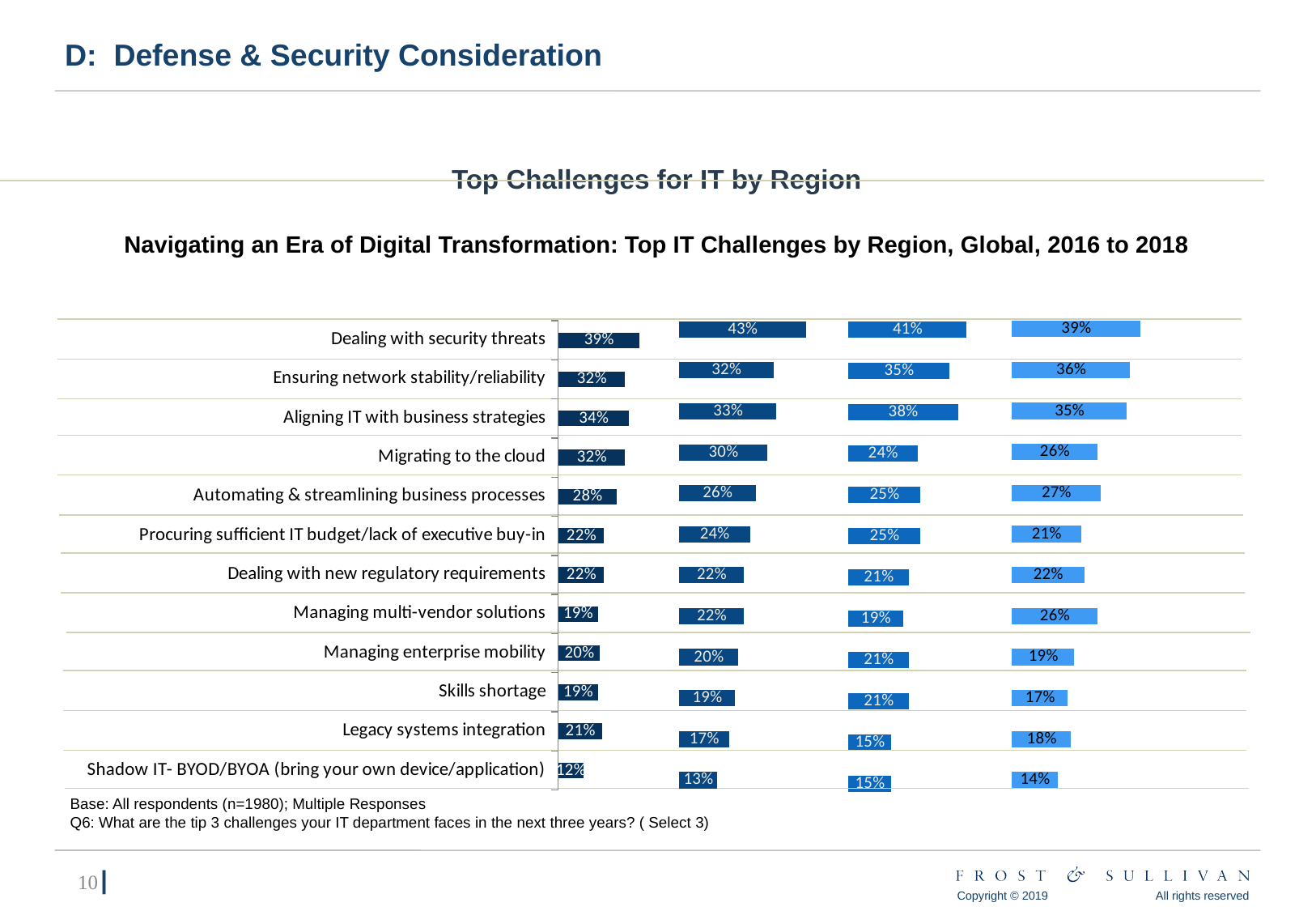
What is the title of the chart on the slide? Navigating an Era of Digital Transformation: Top IT Challenges by Region, Global, 2016 to 2018 In the leftmost column of bars, what is the difference between 'Legacy systems integration' (21%) and 'Shadow IT- BYOD/BYOA' (12%)? 9% How many IT challenge categories are listed in the chart? 12 Which challenge has the highest value in the second column of bars from the left? Dealing with security threats In the leftmost (first) column of bars, what is the value for 'Dealing with security threats'? 39% In the rightmost column of bars, what is the difference between 'Dealing with security threats' (39%) and 'Skills shortage' (17%)? 22% In the rightmost (fourth) column of bars, what is the value for 'Managing multi-vendor solutions'? 26% In the second column of bars from the left, what is the value for 'Migrating to the cloud'? 30% Which challenge has the lowest value in the leftmost column of bars? Shadow IT- BYOD/BYOA (bring your own device/application) What type of chart is shown on the slide? bar chart In the third column of bars from the left, what is the value for 'Aligning IT with business strategies'? 38% In the third column of bars from the left, which is larger: 'Migrating to the cloud' or 'Ensuring network stability/reliability'? Ensuring network stability/reliability